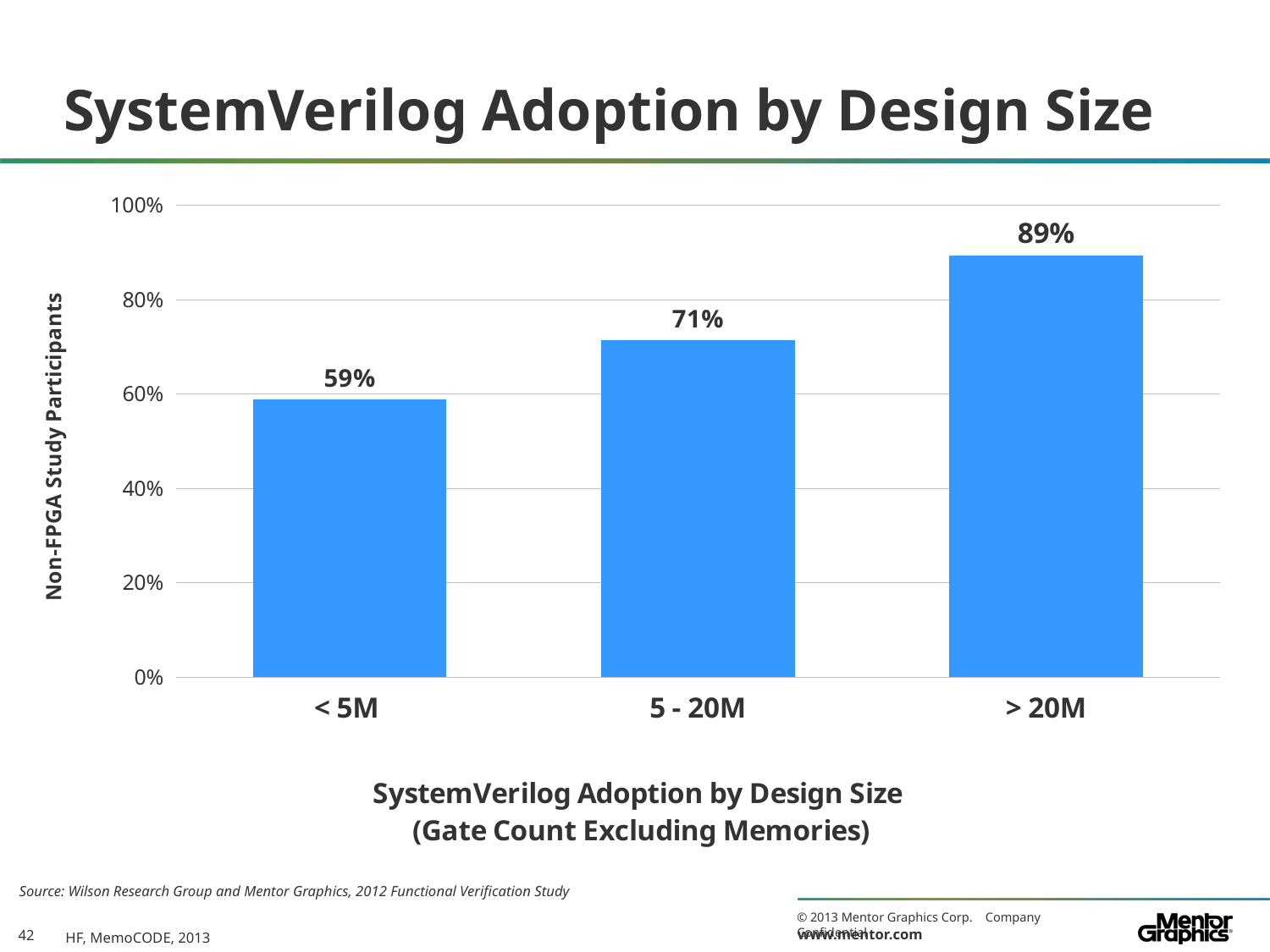
What is the difference in adoption between the > 20M and < 5M categories? 30% What kind of chart is shown on the slide? Bar chart What is the SystemVerilog adoption value for the > 20M design size category? 89% What is the SystemVerilog adoption value for the 5 - 20M design size category? 71% Which has a higher adoption value, 5 - 20M or > 20M? > 20M What is the difference in adoption between the 5 - 20M and < 5M categories? 12% How many design size categories are shown in the chart? 3 Is the value for 5 - 20M greater or less than 80%? less Which design size category has the highest SystemVerilog adoption? > 20M What is the SystemVerilog adoption value for the < 5M design size category? 59% Do the adoption values rise or fall as design size increases along the x axis? Rise Which design size category has the lowest SystemVerilog adoption? < 5M